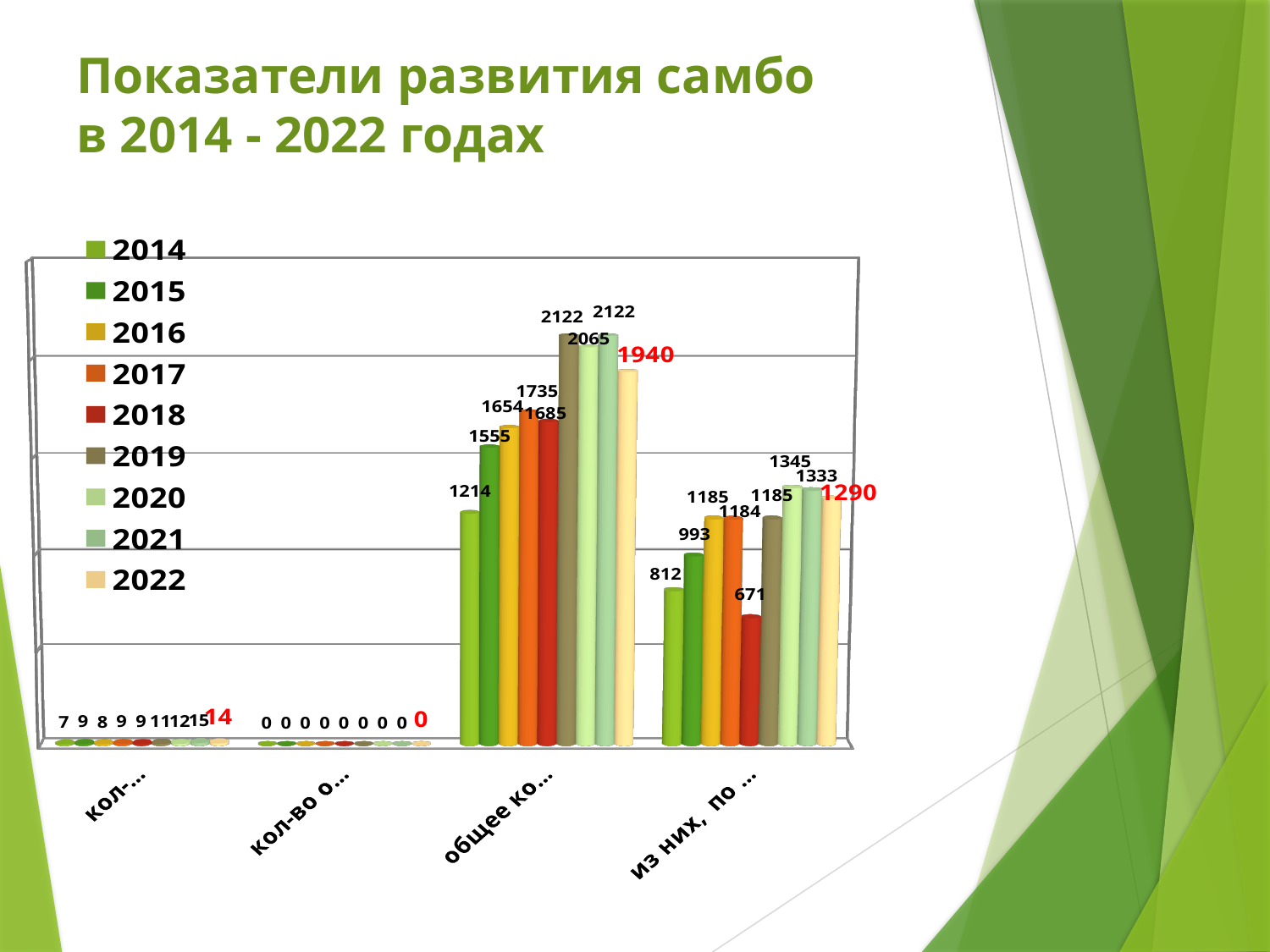
In the third group of bars from the left, what is the value for 2022? 1940 In the third group of bars from the left, which is larger: the value for 2019 or the value for 2022? 2019 What kind of chart is shown on the slide? bar chart How many category groups are shown along the x axis? 4 In the fourth group of bars from the left, what is the value for 2018? 671 What is the title of the slide? Показатели развития самбо в 2014 - 2022 годах In the third group of bars from the left, what is the difference between the 2021 value and the 2014 value? 908 In the fourth group of bars from the left, which year has the lowest value? 2018 In the fourth group of bars from the left, which year has the highest value? 2020 How many series does the legend list? 9 In the third group of bars from the left, what is the value for 2014? 1214 In the fourth group of bars from the left, what is the value for 2022? 1290